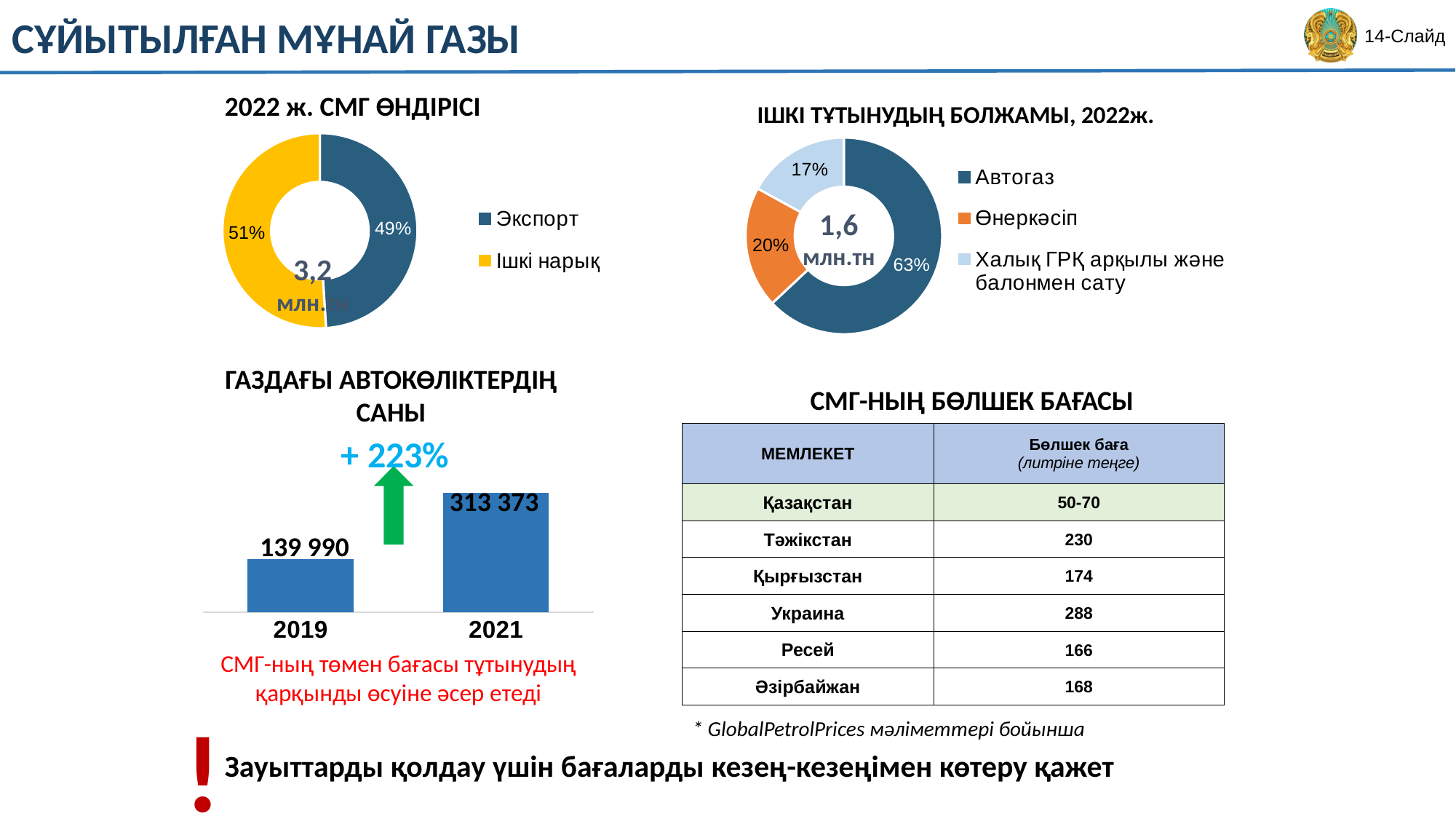
In the 'ІШКІ ТҰТЫНУДЫҢ БОЛЖАМЫ, 2022ж.' chart, what share does Автогаз have? 63% How many categories does the legend of the 'ІШКІ ТҰТЫНУДЫҢ БОЛЖАМЫ, 2022ж.' chart list? 3 In the 'ГАЗДАҒЫ АВТОКӨЛІКТЕРДІҢ САНЫ' chart, do the values rise or fall from 2019 to 2021? Rise In the '2022 ж. СМГ ӨНДІРІСІ' chart, what share does Экспорт have? 49% In the '2022 ж. СМГ ӨНДІРІСІ' chart, what share does Ішкі нарық have? 51% In the 'ІШКІ ТҰТЫНУДЫҢ БОЛЖАМЫ, 2022ж.' chart, what is the difference between the Автогаз and Өнеркәсіп shares? 43% In the 'ГАЗДАҒЫ АВТОКӨЛІКТЕРДІҢ САНЫ' chart, what is the difference between the 2021 and 2019 values? 173 383 In the '2022 ж. СМГ ӨНДІРІСІ' chart, which segment is larger, Экспорт or Ішкі нарық? Ішкі нарық In the 'ІШКІ ТҰТЫНУДЫҢ БОЛЖАМЫ, 2022ж.' chart, which category has the smallest share? Халық ГРҚ арқылы және балонмен сату In the 'ГАЗДАҒЫ АВТОКӨЛІКТЕРДІҢ САНЫ' chart, what is the value for 2021? 313 373 What kind of chart is '2022 ж. СМГ ӨНДІРІСІ'? Donut (pie) chart